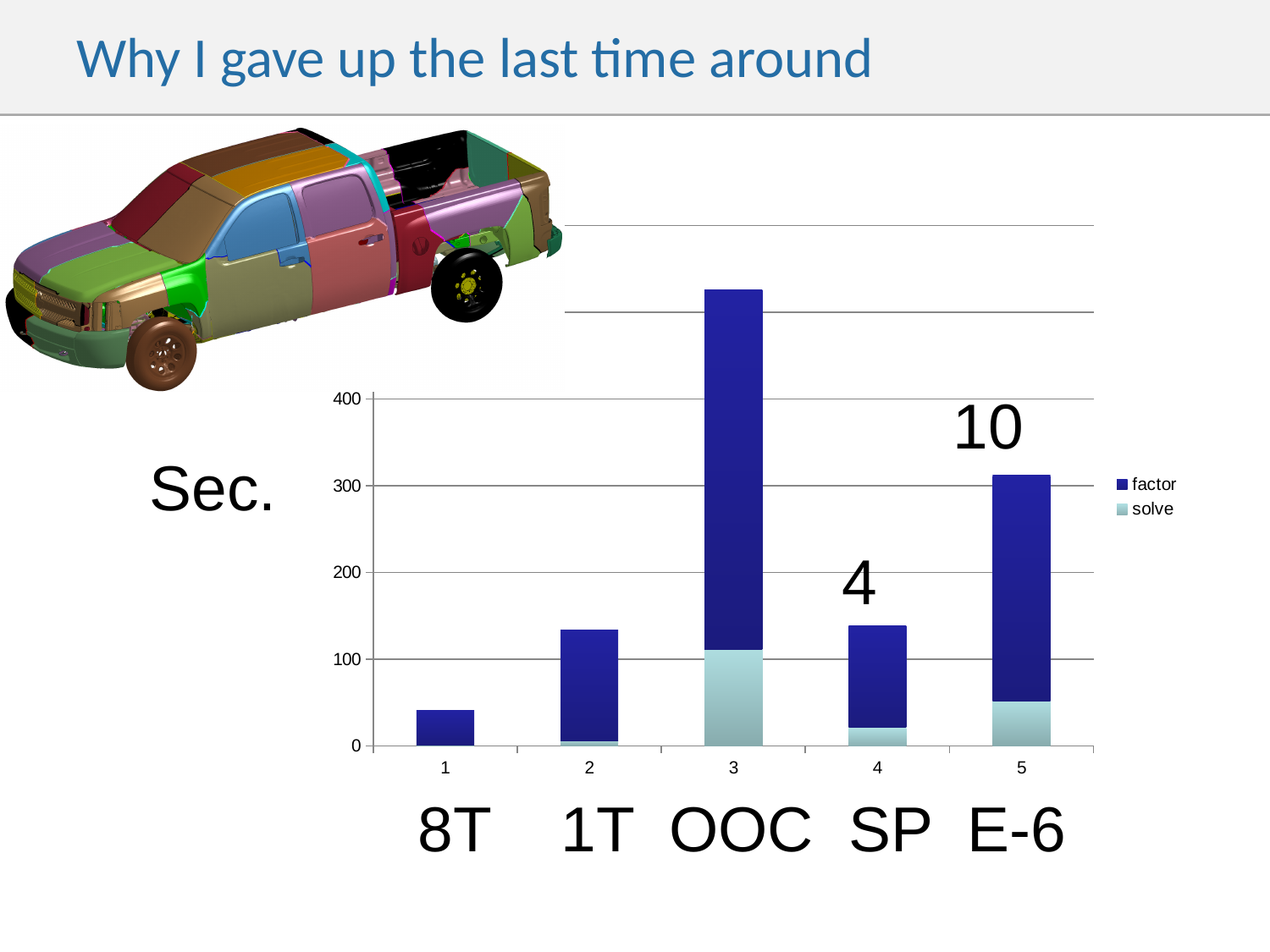
Which category has the largest 'solve' segment? 3 (OOC) Is the total for category 3 (OOC) greater or less than 400? greater How many bars (categories) are plotted on the x axis? 5 Is the total for category 2 (1T) greater or less than 100? greater Which series is shown in dark blue in the legend? factor Which stacked bar is taller, category 3 (OOC) or category 5 (E-6)? category 3 (OOC) Which category has the tallest stacked bar? 3 (OOC) Is the total for category 5 (E-6) greater or less than 200? greater How many series does the chart legend list? 2 Which category has the shortest stacked bar? 1 (8T) What kind of chart is shown on the slide? stacked bar chart